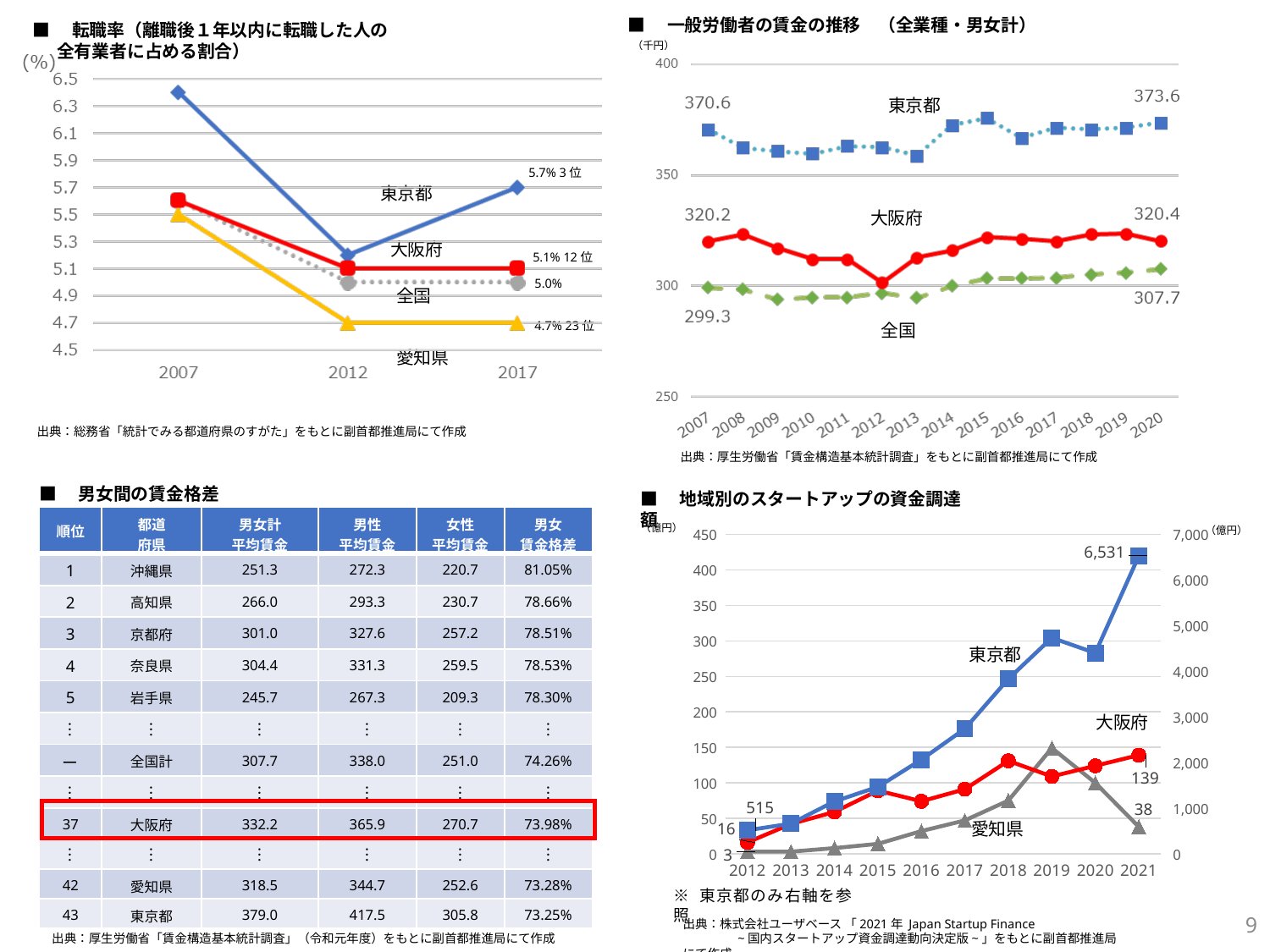
In the 転職率 chart (top left), what is the difference between 東京都 and 大阪府 in 2017? 0.6% In the 一般労働者の賃金の推移 chart (top right), what is the value for 全国 in 2007? 299.3 In the 転職率 chart (top left), what is the value for 東京都 in 2017? 5.7% In the 転職率 chart (top left), how many years are shown on the x axis? 3 In the 一般労働者の賃金の推移 chart (top right), what is the value for 東京都 in 2020? 373.6 In the 転職率 chart (top left), what is the value for 愛知県 in 2017? 4.7% In the 地域別のスタートアップの資金調達額 chart (bottom right), what is the difference between 大阪府 and 愛知県 in 2021? 101 In the 一般労働者の賃金の推移 chart (top right), is the value for 大阪府 in 2012 greater or less than 350? less What kind of chart is the 地域別のスタートアップの資金調達額 chart (bottom right)? line chart In the 一般労働者の賃金の推移 chart (top right), which series has the lowest value in 2020? 全国 In the 転職率 chart (top left), which series has the highest value in 2017? 東京都 In the 地域別のスタートアップの資金調達額 chart (bottom right), what is the value for 東京都 in 2021? 6,531